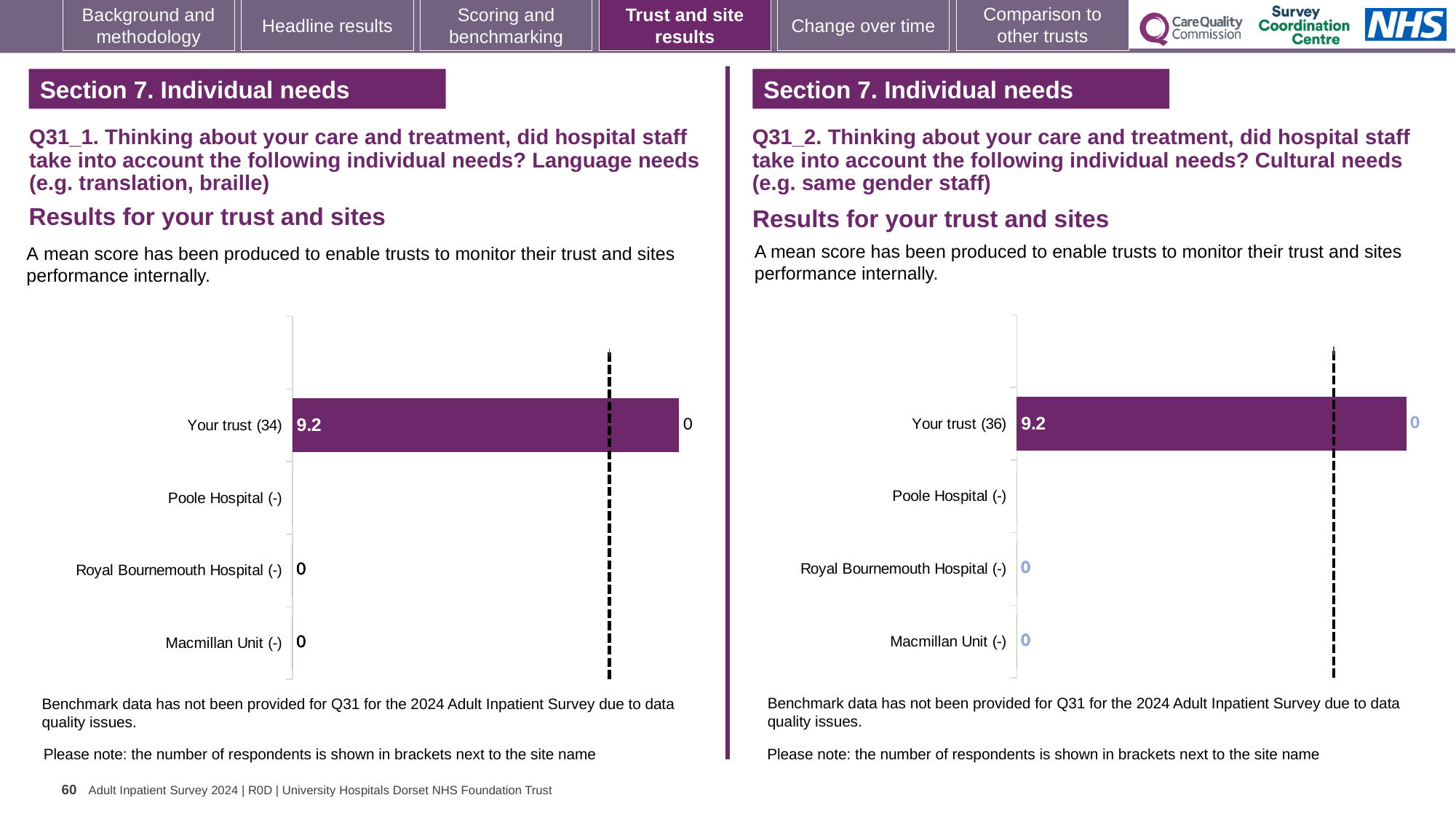
What kind of chart is used on the left side of the slide for Q31_1? Bar chart On the right chart (Q31_2, Cultural needs), which category has the highest mean score? Your trust (36) On the right chart (Q31_2, Cultural needs), how many categories are listed on the vertical axis? 4 What kind of chart is used on the right side of the slide for Q31_2? Bar chart On the right chart (Q31_2, Cultural needs), how many respondents are shown in brackets for Your trust? 36 On the right chart (Q31_2, Cultural needs), what is the mean score for Your trust? 9.2 On the left chart (Q31_1, Language needs), how many respondents are shown in brackets for Your trust? 34 On the left chart (Q31_1, Language needs), what is the mean score for Your trust? 9.2 On the left chart (Q31_1, Language needs), which category has the highest mean score? Your trust (34) On the left chart (Q31_1, Language needs), which category is listed directly below Your trust (34)? Poole Hospital (-) Which section of the survey do both charts on the slide belong to? Section 7. Individual needs On the left chart (Q31_1, Language needs), how many categories are listed on the vertical axis? 4